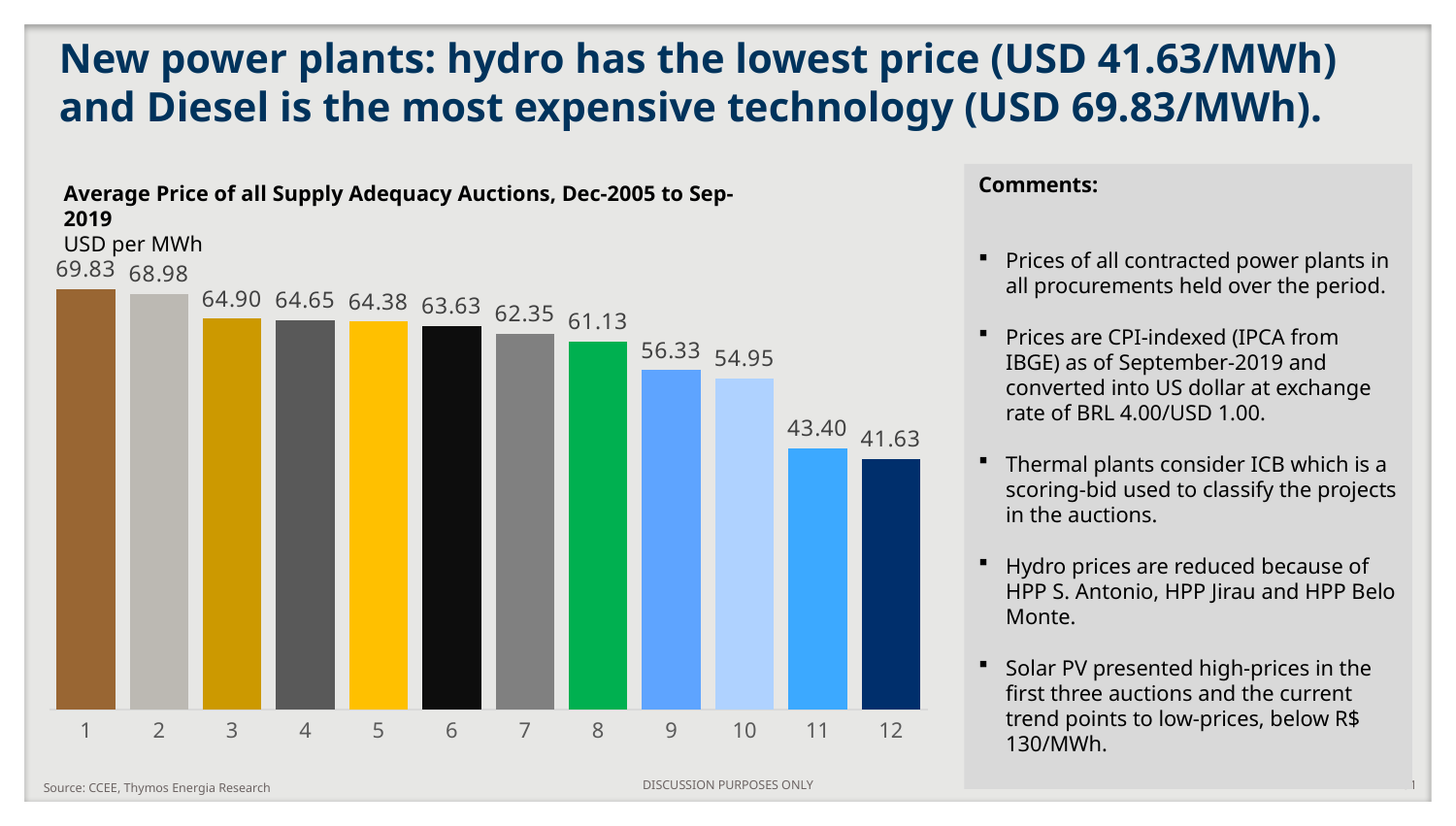
Do the values rise or fall from category 1 to category 12? fall What kind of chart is shown on the slide? bar chart What is the value for category 1? 69.83 What is the difference between the values for category 10 and category 11? 11.55 What is the difference between the values for category 1 and category 12? 28.20 Which category has the lowest value? 12 What unit is stated below the chart title? USD per MWh Which is larger, the value for category 3 or the value for category 8? category 3 What is the value for category 12? 41.63 What is the value for category 9? 56.33 How many bars are plotted in the chart? 12 Which category has the highest value? 1